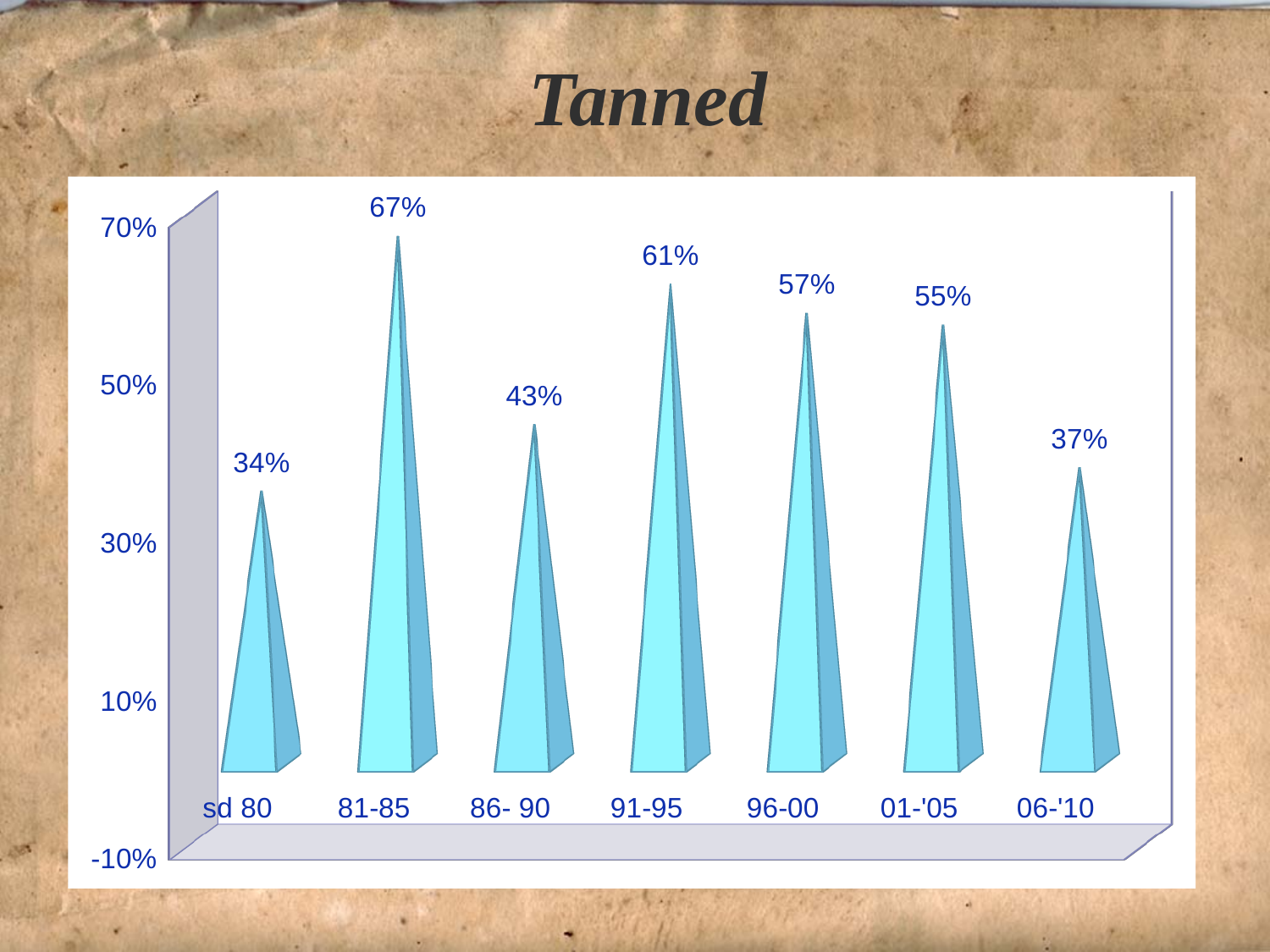
Which category has the highest value? 81-85 What is the value for 96-00? 57% What is the value for sd 80? 34% Which is larger, the value for 86- 90 or the value for 06-'10? 86- 90 Which category has the lowest value? sd 80 What is the value for 06-'10? 37% What is the difference between the values for 81-85 and 86- 90? 24% What is the title of the slide? Tanned What kind of chart is shown on the slide? bar chart What is the difference between the values for 91-95 and 01-'05? 6% What is the value for 81-85? 67% How many categories are shown on the x axis? 7